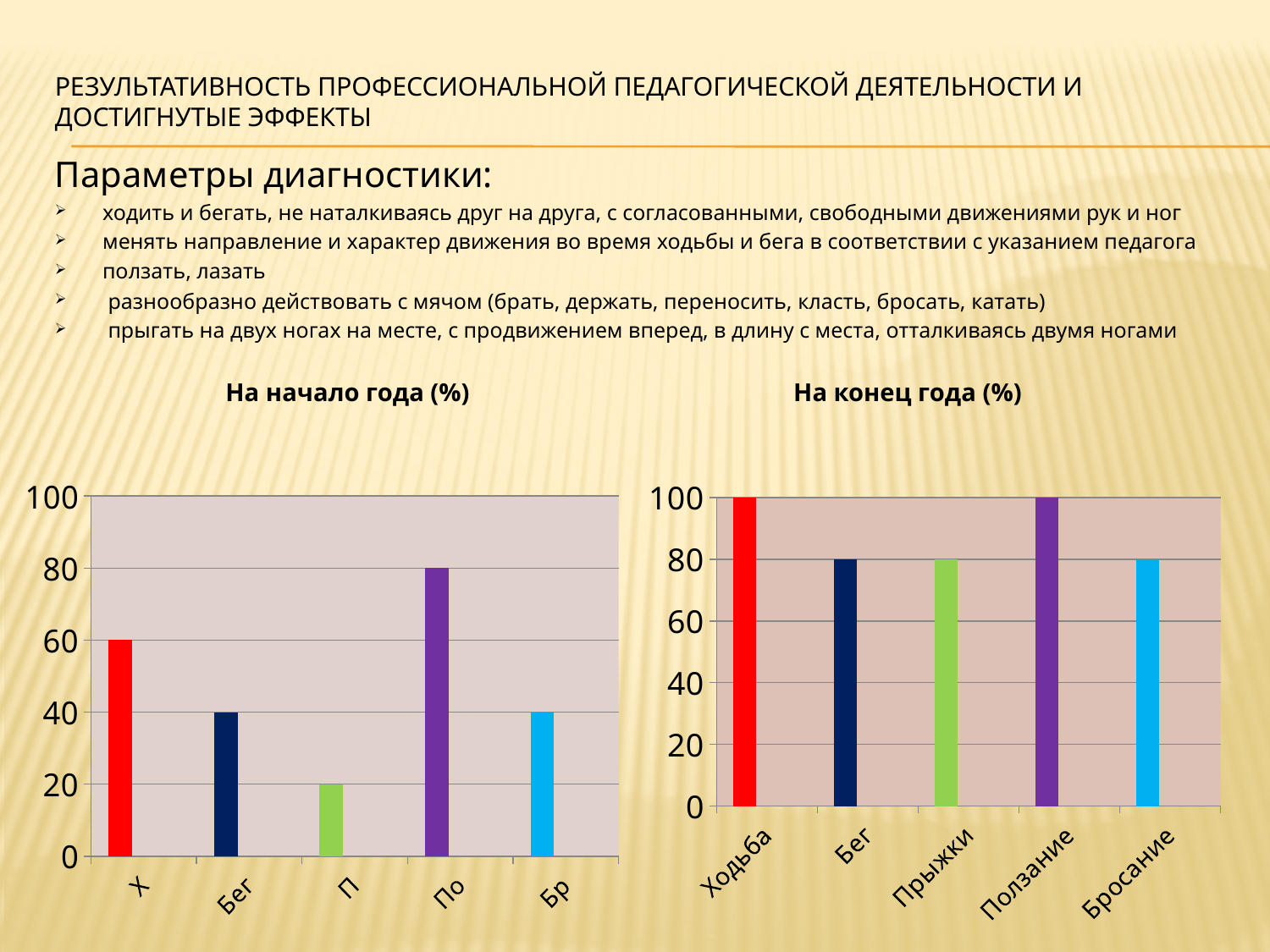
On the chart titled 'На конец года (%)', what is the value for Ходьба? 100 On the chart titled 'На начало года (%)', how many categories are shown? 5 On the chart titled 'На начало года (%)', which category has the lowest value? П On the chart titled 'На начало года (%)', what is the value for По? 80 On the chart titled 'На конец года (%)', which is larger, the value for Ползание or the value for Бросание? Ползание On the chart titled 'На начало года (%)', which category has the highest value? По On the chart titled 'На начало года (%)', what colour is the bar for Бег? dark blue On the chart titled 'На начало года (%)', what is the difference between the values for По and Х? 20 On the chart titled 'На начало года (%)', what is the value for П? 20 What kind of chart is the chart titled 'На конец года (%)'? bar chart On the chart titled 'На конец года (%)', what is the value for Прыжки? 80 On the chart titled 'На конец года (%)', is the value for Бег greater or less than 60? greater